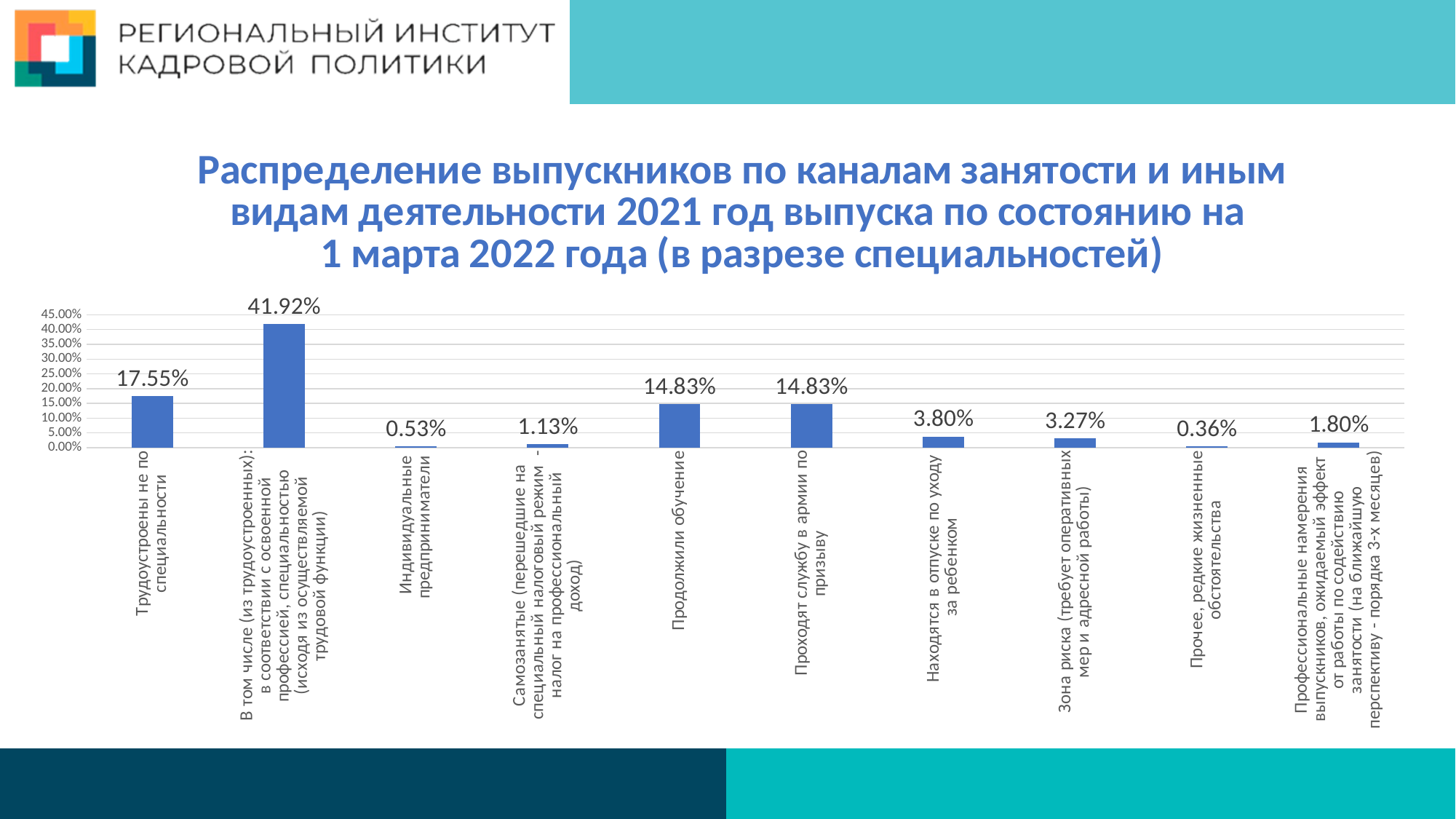
What is the value for "Индивидуальные предприниматели"? 0.53% What is the difference between the values for "Трудоустроены не по специальности" and "Проходят службу в армии по призыву"? 2.72% Which category has the highest value? В том числе (из трудоустроенных): в соответствии с освоенной профессией, специальностью (исходя из осуществляемой трудовой функции) What is the value for "Находятся в отпуске по уходу за ребенком"? 3.80% Which is larger: the value for "Зона риска (требует оперативных мер и адресной работы)" or the value for "Находятся в отпуске по уходу за ребенком"? Находятся в отпуске по уходу за ребенком How many categories are shown in the chart? 10 Which category has the lowest value? Прочее, редкие жизненные обстоятельства Is the value for "Трудоустроены не по специальности" greater or less than 15.00%? greater What is the value for "Самозанятые (перешедшие на специальный налоговый режим - налог на профессиональный доход)"? 1.13% What kind of chart is shown on the slide? bar chart What is the value for "Продолжили обучение"? 14.83% What is the value for "Трудоустроены не по специальности"? 17.55%